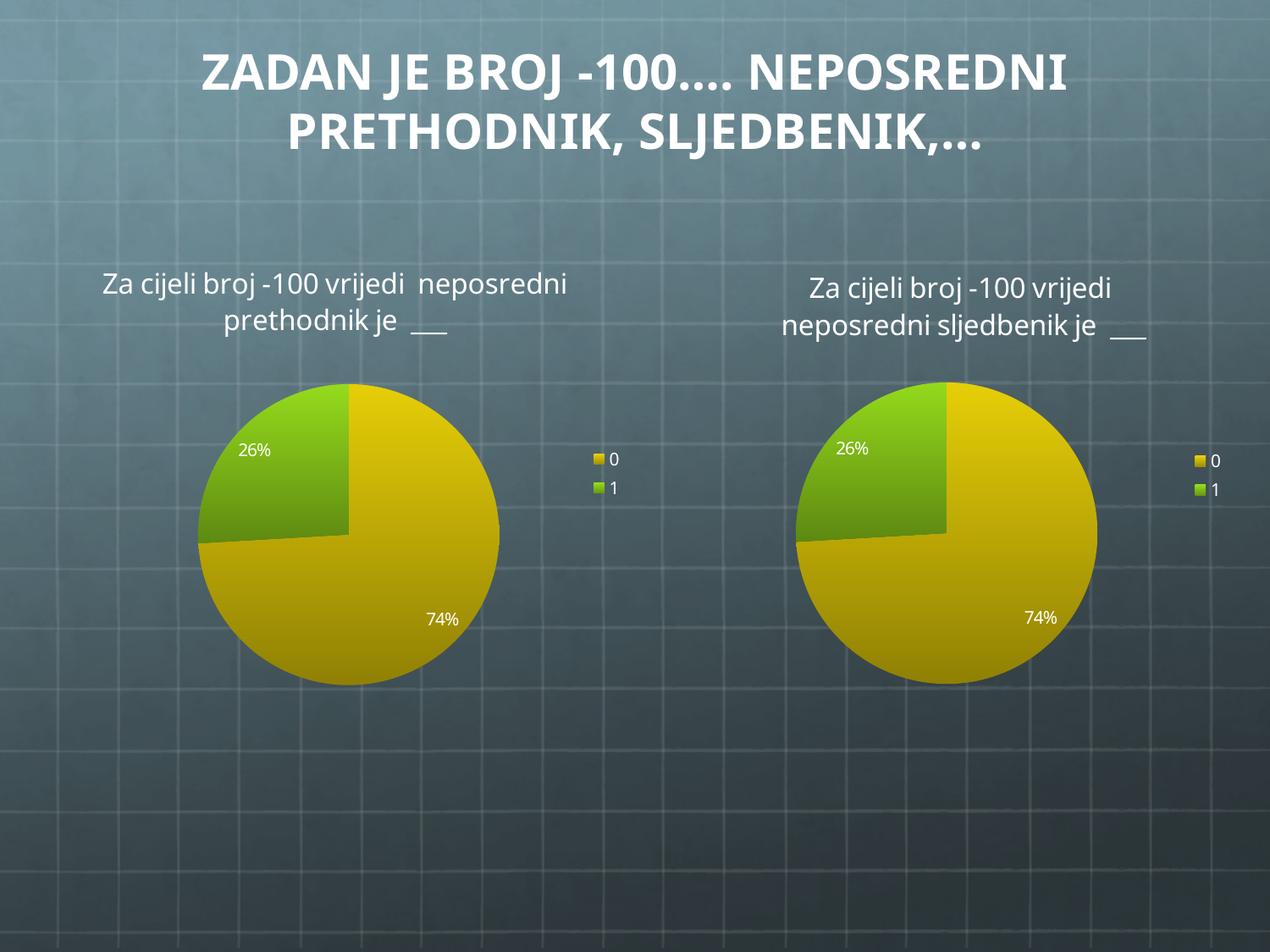
In the right pie chart, which category has the smallest slice? 1 In the right pie chart, is the slice for 0 larger or smaller than the slice for 1? larger In the right pie chart, what share does category 0 have? 74% What kind of chart is shown on the left of the slide? pie chart In the right pie chart, what colour is the slice for category 1? green In the right pie chart, what share does category 1 have? 26% In the left pie chart, what share does category 1 have? 26% How many entries does the legend of the left pie chart list? 2 In the left pie chart, which category has the largest slice? 0 In the left pie chart, what is the difference in percentage points between the slices for 0 and 1? 48 In the left pie chart, what share does category 0 have? 74% How many slices does the right pie chart have? 2